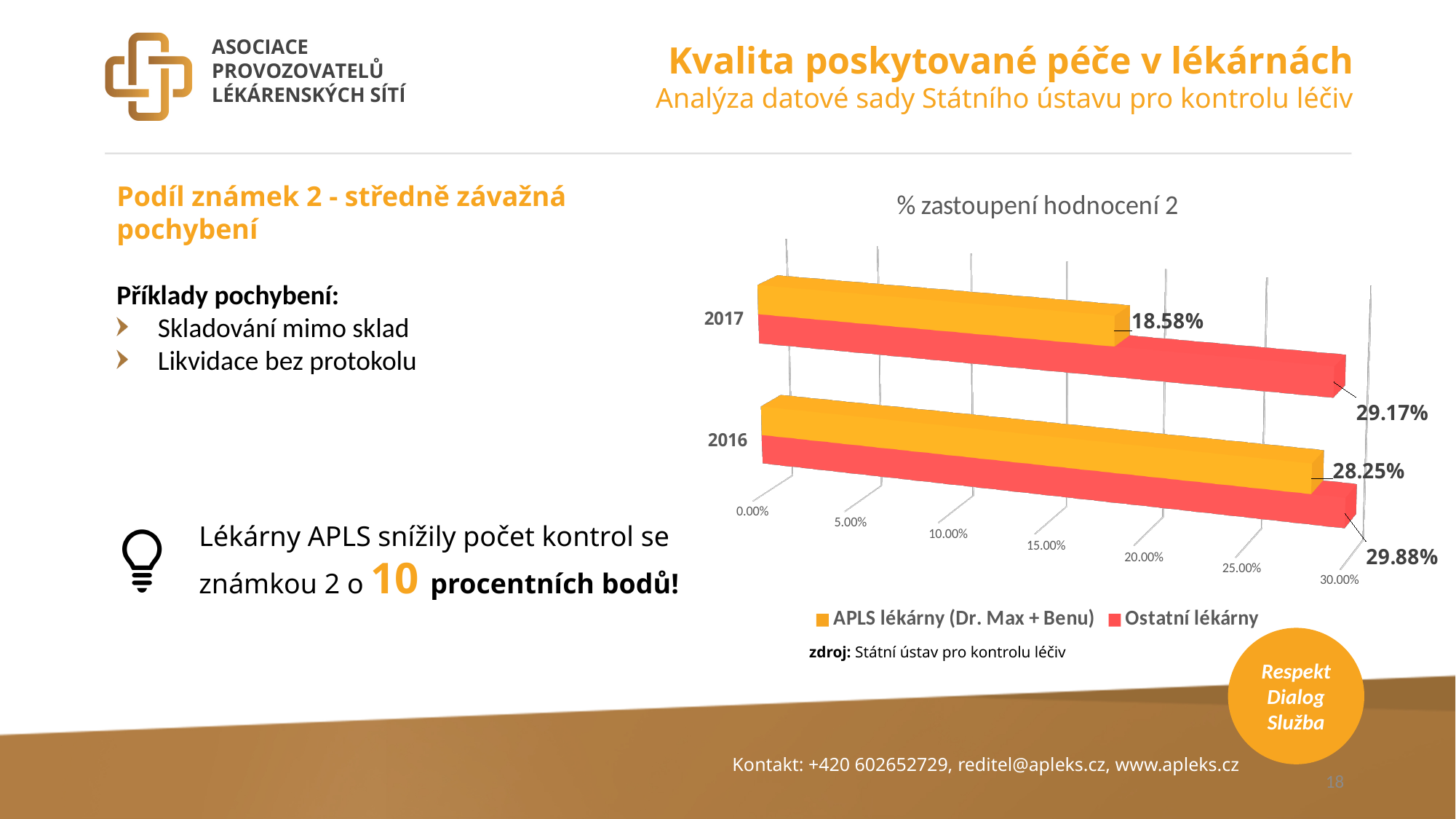
Which year has the lower value for APLS lékárny (Dr. Max + Benu)? 2017 What is the title of the chart? % zastoupení hodnocení 2 What kind of chart is shown on the slide? bar chart What is the value for APLS lékárny (Dr. Max + Benu) in 2016? 28.25% What is the value for APLS lékárny (Dr. Max + Benu) in 2017? 18.58% How many series does the legend list? 2 What is the value for Ostatní lékárny in 2016? 29.88% What is the difference between the Ostatní lékárny value and the APLS lékárny value in 2017? 10.59% Which is larger in 2016: the APLS lékárny value or the Ostatní lékárny value? Ostatní lékárny Is the value for APLS lékárny (Dr. Max + Benu) in 2017 greater or less than 20.00%? less What is the value for Ostatní lékárny in 2017? 29.17% By how much did the APLS lékárny (Dr. Max + Benu) value fall from 2016 to 2017? 9.67%